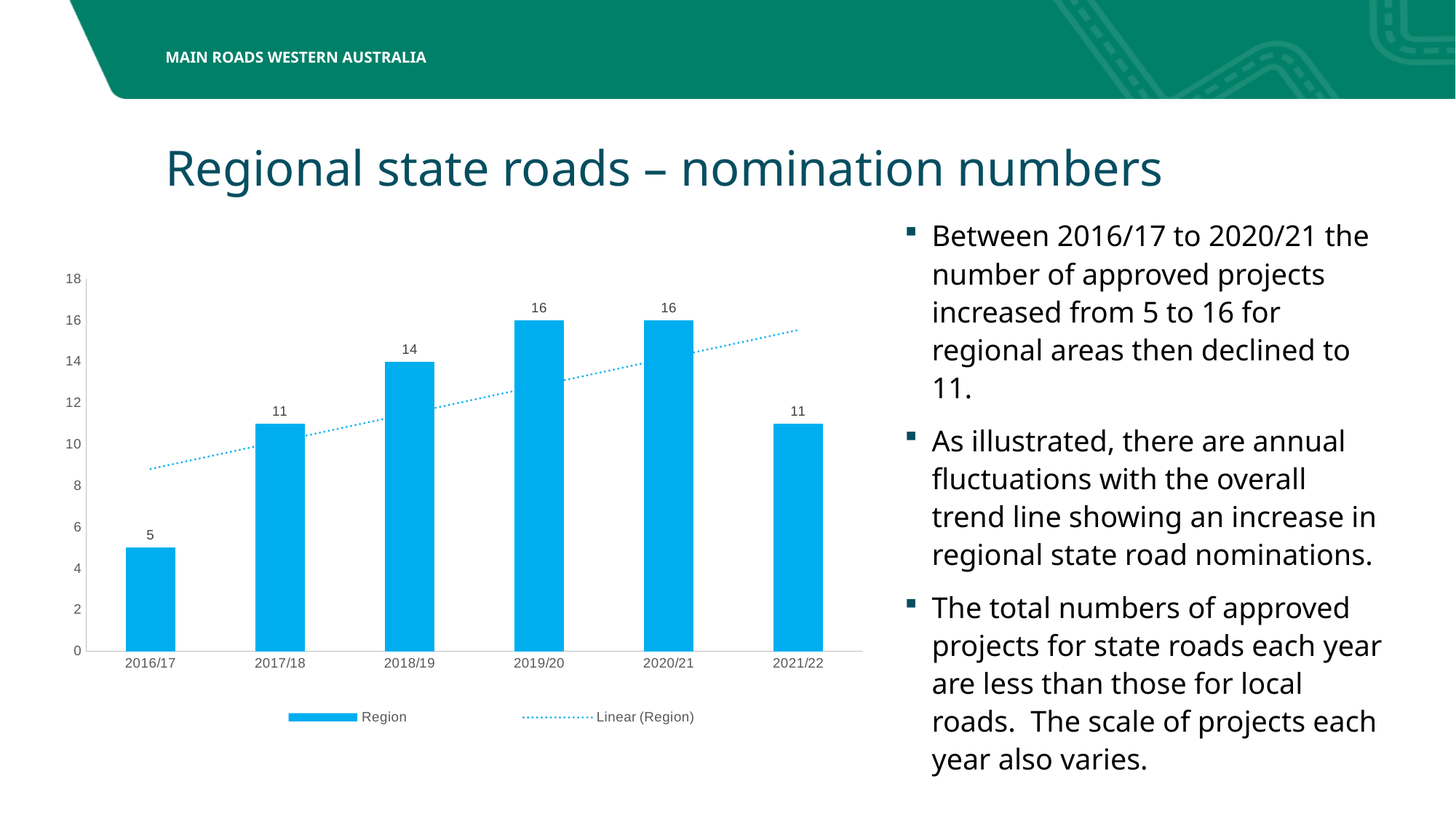
What is the difference between the values for 2019/20 and 2016/17? 11 What is the difference between the values for 2020/21 and 2021/22? 5 Which is larger, the value for 2017/18 or the value for 2018/19? 2018/19 What is the value for 2018/19? 14 How many years are shown on the x axis? 6 What is the value for 2021/22? 11 What kind of chart is shown? bar chart Is the value for 2019/20 greater or less than 10? greater How many entries does the legend list? 2 Which year has the lowest value? 2016/17 What is the value for 2016/17? 5 Do the values rise or fall from 2016/17 to 2019/20? rise